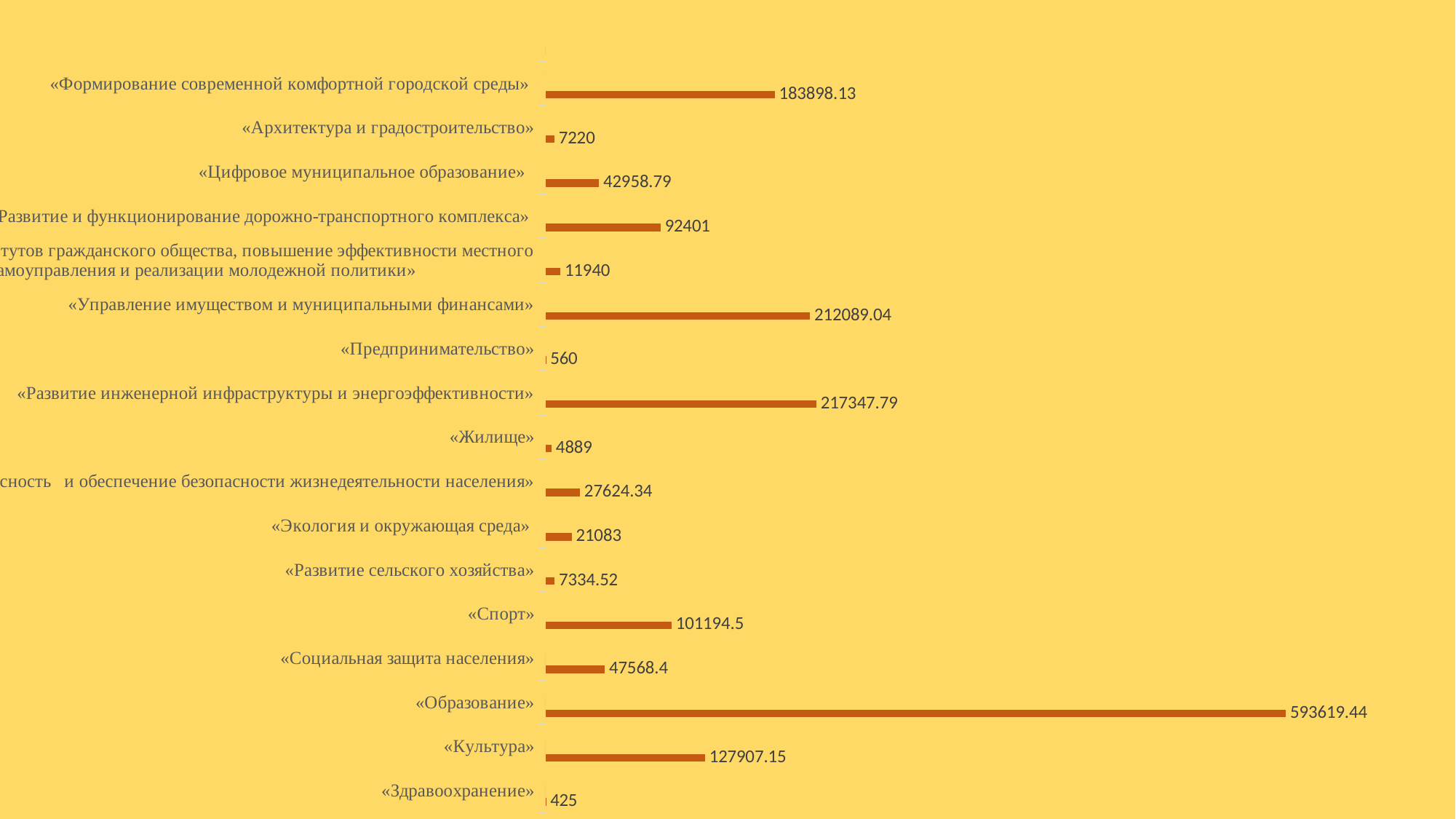
Which category has the lowest value? «Здравоохранение» Which category has the highest value? «Образование» What is the difference between the values for «Образование» and «Культура»? 465712.29 What is the value for «Формирование современной комфортной городской среды»? 183898.13 What is the value for «Образование»? 593619.44 How many categories are plotted in the chart? 17 What type of chart is shown on the slide? bar chart What is the value for «Спорт»? 101194.5 Which has a larger value, «Спорт» or «Культура»? «Культура» What is the value for «Культура»? 127907.15 What is the value for «Здравоохранение»? 425 What is the difference between the values for «Спорт» and «Социальная защита населения»? 53626.1